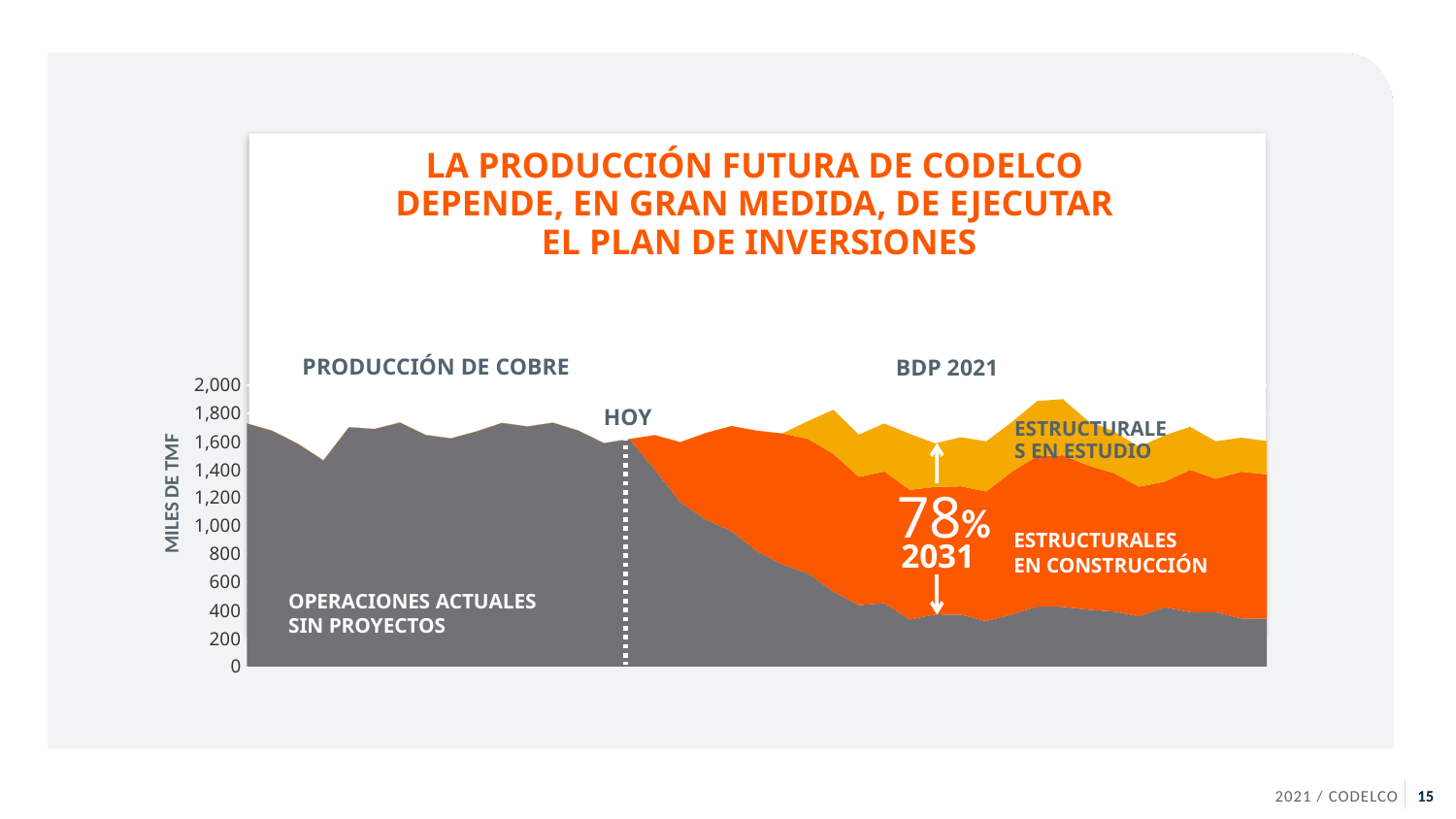
At the left end of the chart, is the value of 'OPERACIONES ACTUALES SIN PROYECTOS' greater or less than 1,400? greater What is the title printed above the chart? LA PRODUCCIÓN FUTURA DE CODELCO DEPENDE, EN GRAN MEDIDA, DE EJECUTAR EL PLAN DE INVERSIONES What percentage is annotated on the chart for the year 2031? 78% At the right end of the chart, is the top of the stacked areas greater or less than 1,200? greater How many series (shaded areas) are labelled in the chart? 3 Does the 'OPERACIONES ACTUALES SIN PROYECTOS' area rise or fall after the 'HOY' line? Fall Which series is stacked at the bottom of the chart? OPERACIONES ACTUALES SIN PROYECTOS What is the highest tick value shown on the vertical axis? 2,000 What kind of chart is shown on the slide? Area chart Which series is stacked at the top of the chart? ESTRUCTURALES EN ESTUDIO At the right end of the chart, is the value of 'OPERACIONES ACTUALES SIN PROYECTOS' greater or less than 600? less What is the label of the vertical axis of the chart? MILES DE TMF